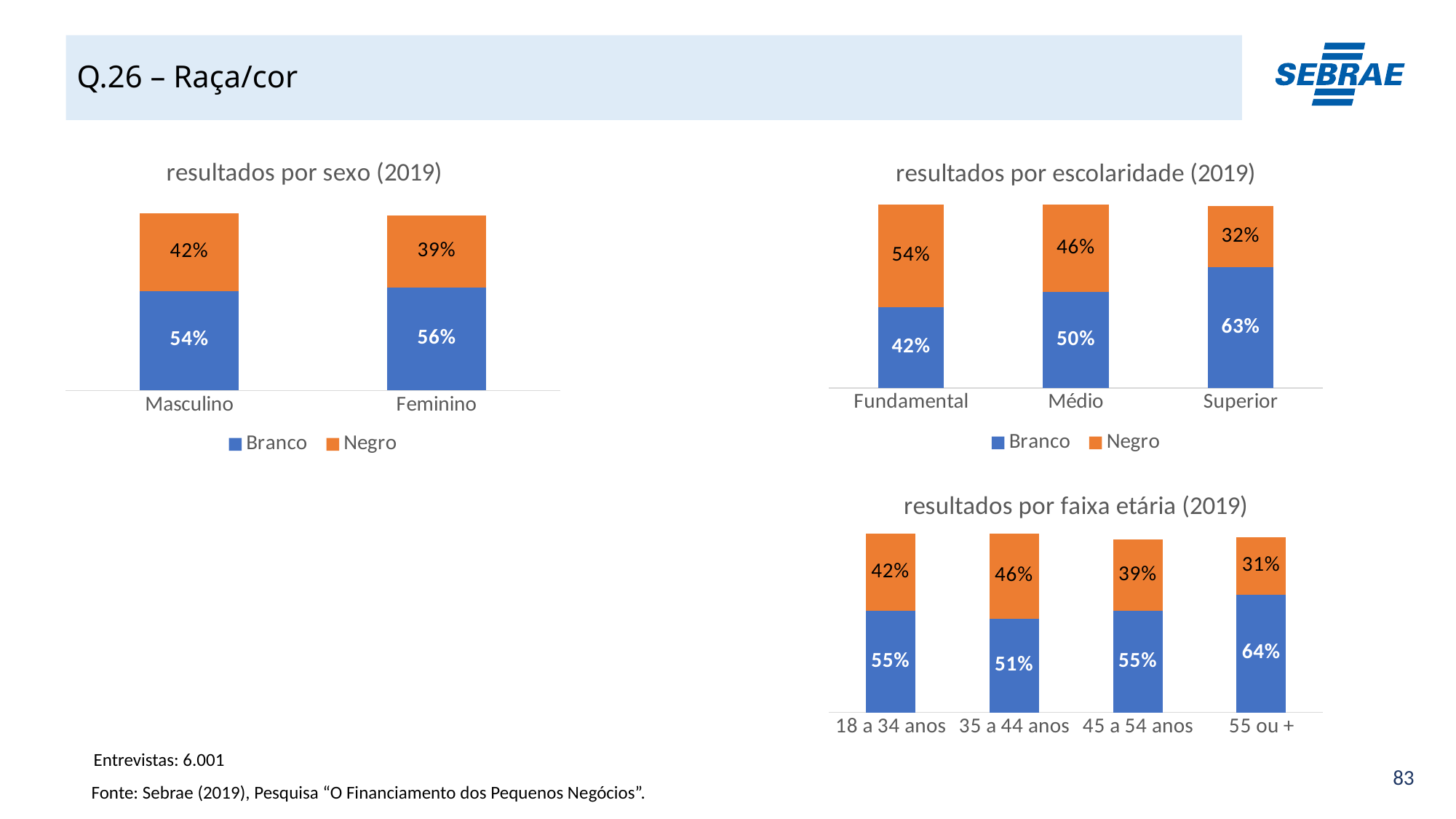
In the chart 'resultados por escolaridade (2019)', what is the total of the stacked bar for Médio? 96% In the chart 'resultados por escolaridade (2019)', what is the value of Branco for Superior? 63% In the chart 'resultados por escolaridade (2019)', what is the difference between the Branco values for Superior and Fundamental? 21 percentage points In the chart 'resultados por escolaridade (2019)', which category has the highest Negro value? Fundamental How many series does the legend of the chart 'resultados por sexo (2019)' list? 2 In the chart 'resultados por sexo (2019)', what is the value of Branco for Masculino? 54% What kind of chart is 'resultados por sexo (2019)'? stacked bar chart In the chart 'resultados por sexo (2019)', what is the value of Negro for Feminino? 39% In the chart 'resultados por faixa etária (2019)', is the Negro value for 18 a 34 anos larger or smaller than for 45 a 54 anos? larger In the chart 'resultados por faixa etária (2019)', which category has the lowest Branco value? 35 a 44 anos In the chart 'resultados por faixa etária (2019)', what is the value of Negro for 55 ou +? 31% In the chart 'resultados por faixa etária (2019)', how many age categories are shown? 4